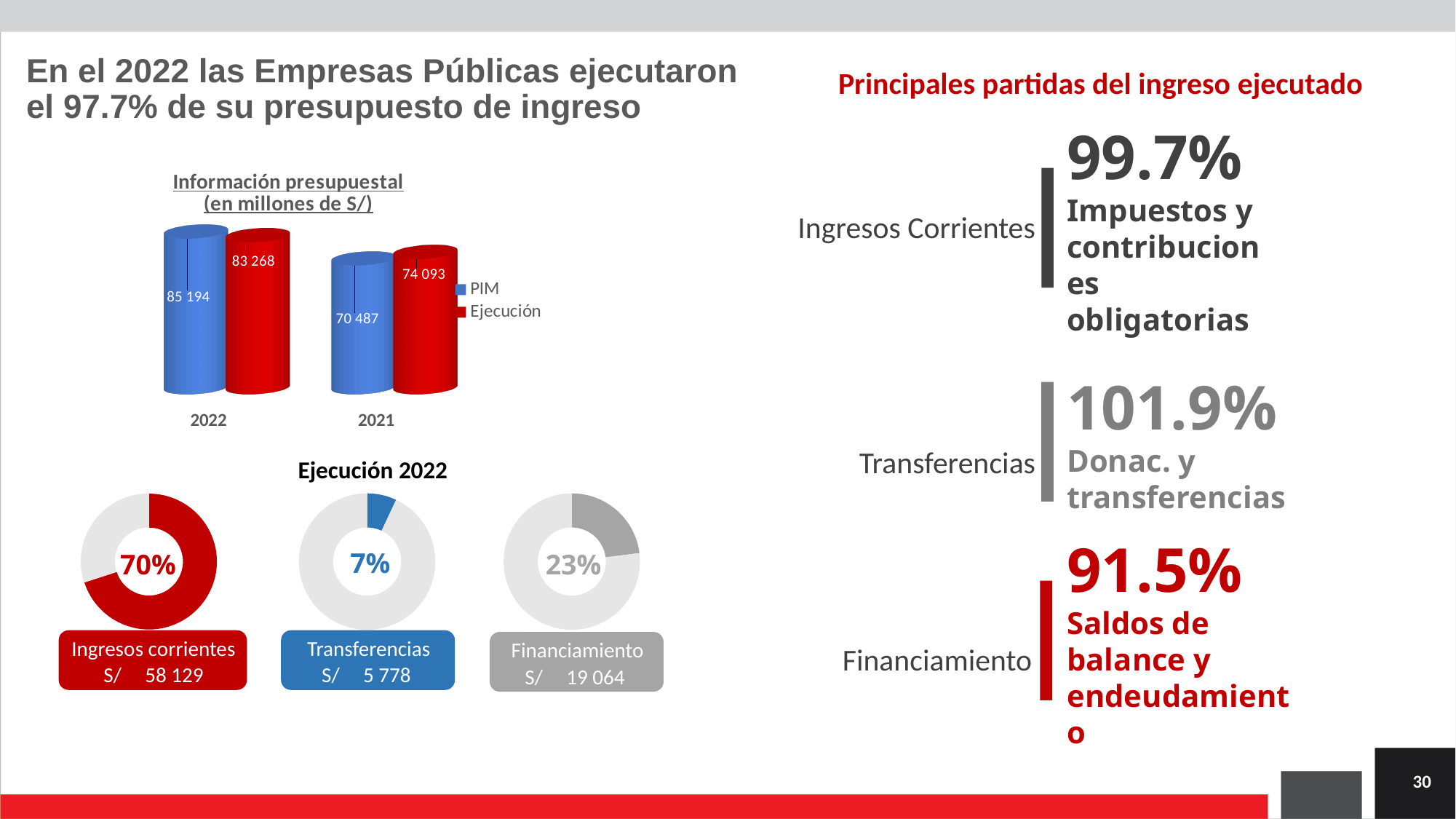
In the 'Información presupuestal' chart, what is the difference between PIM and Ejecución in 2022? 1 926 In the 'Información presupuestal' chart, what is the PIM value for 2022? 85 194 What kind of chart is the 'Información presupuestal' chart? Bar chart In the 'Información presupuestal' chart, which is larger in 2021, PIM or Ejecución? Ejecución How many series does the legend of the 'Información presupuestal' chart list? 2 In the 'Ejecución 2022' donut charts, which category has the largest share? Ingresos corrientes In the 'Ejecución 2022' donut charts, what share is shown for Transferencias? 7% In the 'Información presupuestal' chart, which year has the highest PIM value? 2022 In the 'Ejecución 2022' donut charts, what share is shown for Financiamiento? 23% In the 'Información presupuestal' chart, what is the PIM value for 2021? 70 487 In the 'Información presupuestal' chart, what is the Ejecución value for 2021? 74 093 In the 'Información presupuestal' chart, which colour represents Ejecución? Red